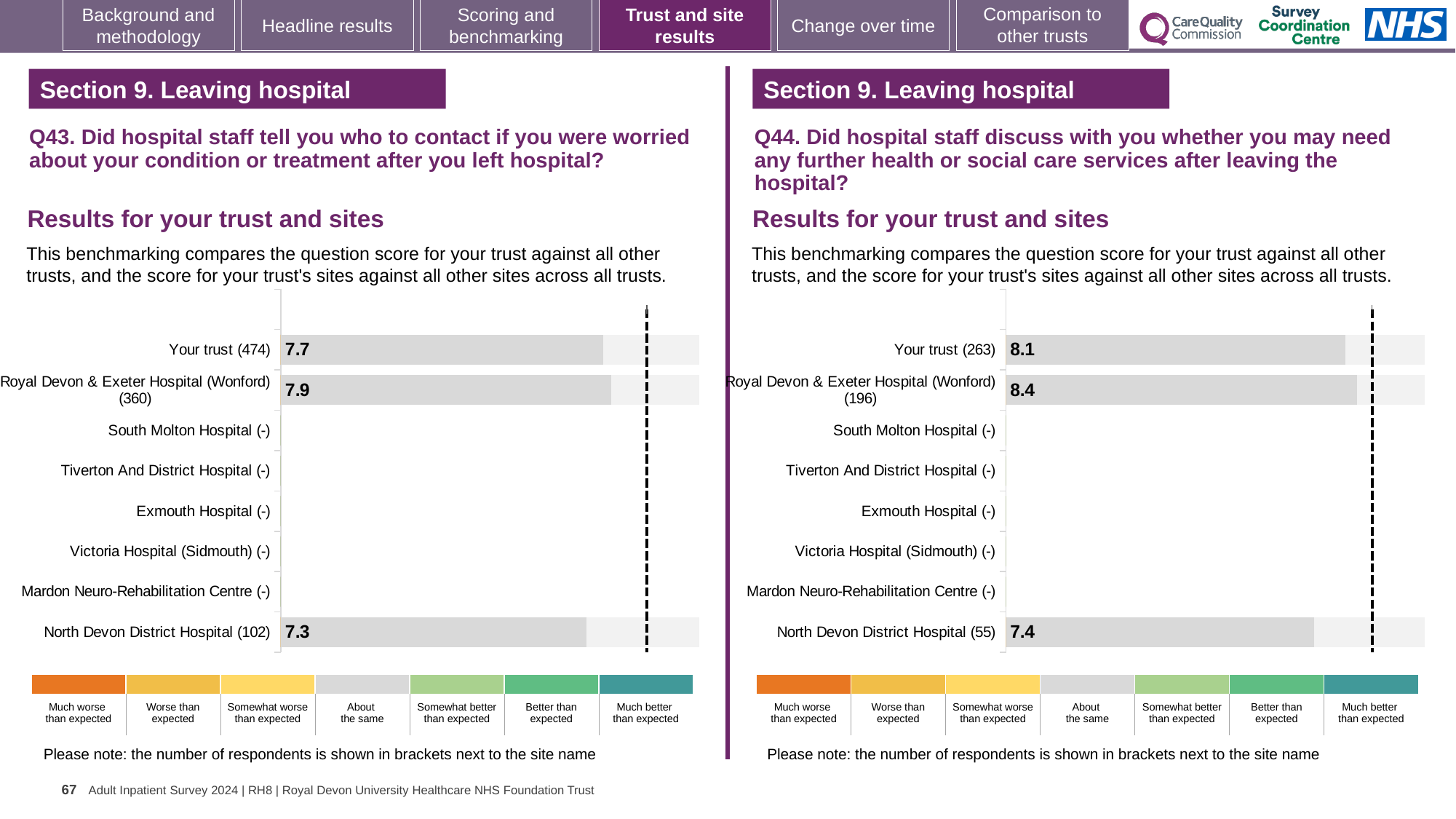
In the Q43 chart on the left, what is the score for North Devon District Hospital (102)? 7.3 In the Q43 chart on the left, which has the larger score: Your trust or North Devon District Hospital? Your trust In the Q44 chart on the right, what is the difference between the scores for Royal Devon & Exeter Hospital (Wonford) and North Devon District Hospital? 1.0 What kind of chart is used on this slide? Bar chart In the Q44 chart on the right, what is the score for Royal Devon & Exeter Hospital (Wonford) (196)? 8.4 In the Q43 chart on the left, which row has the highest score? Royal Devon & Exeter Hospital (Wonford) (360) In the Q43 chart on the left, what is the score for Royal Devon & Exeter Hospital (Wonford) (360)? 7.9 In the Q43 chart on the left, how many rows have a score bar plotted? 3 In the Q44 chart on the right, what is the score for Your trust (263)? 8.1 In the Q44 chart on the right, which row has the lowest score? North Devon District Hospital (55) In the Q43 chart on the left, what is the score for Your trust (474)? 7.7 In the Q44 chart on the right, what is the score for North Devon District Hospital (55)? 7.4